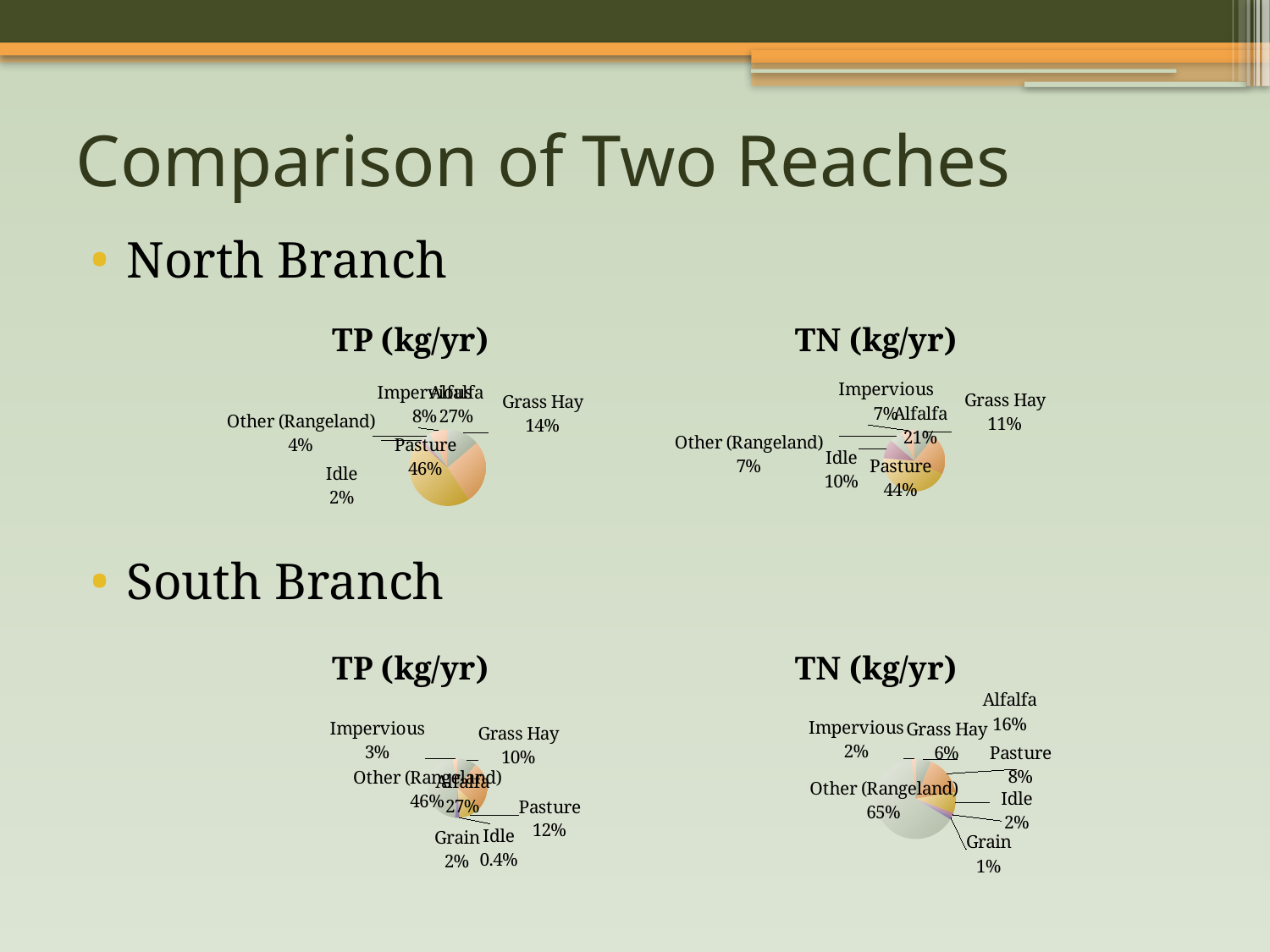
In the South Branch TP (kg/yr) chart, what share does Other (Rangeland) have? 46% In the South Branch TN (kg/yr) chart, which is larger, the Alfalfa share or the Pasture share? Alfalfa In the North Branch TN (kg/yr) chart, what share does Idle have? 10% In the South Branch TN (kg/yr) chart, what share does Other (Rangeland) have? 65% In the South Branch TP (kg/yr) chart, which category has the smallest share? Idle In the North Branch TP (kg/yr) chart, what share does Grass Hay have? 14% In the North Branch TN (kg/yr) chart, what is the difference between the Pasture share and the Alfalfa share? 23% In the North Branch TN (kg/yr) chart, which category has the largest share? Pasture In the North Branch TP (kg/yr) chart, what share does Pasture have? 46% In the South Branch TN (kg/yr) chart, what share does Grain have? 1% How many categories are shown in the South Branch TP (kg/yr) pie chart? 7 What kind of chart is used for the North Branch TP (kg/yr) data? Pie chart